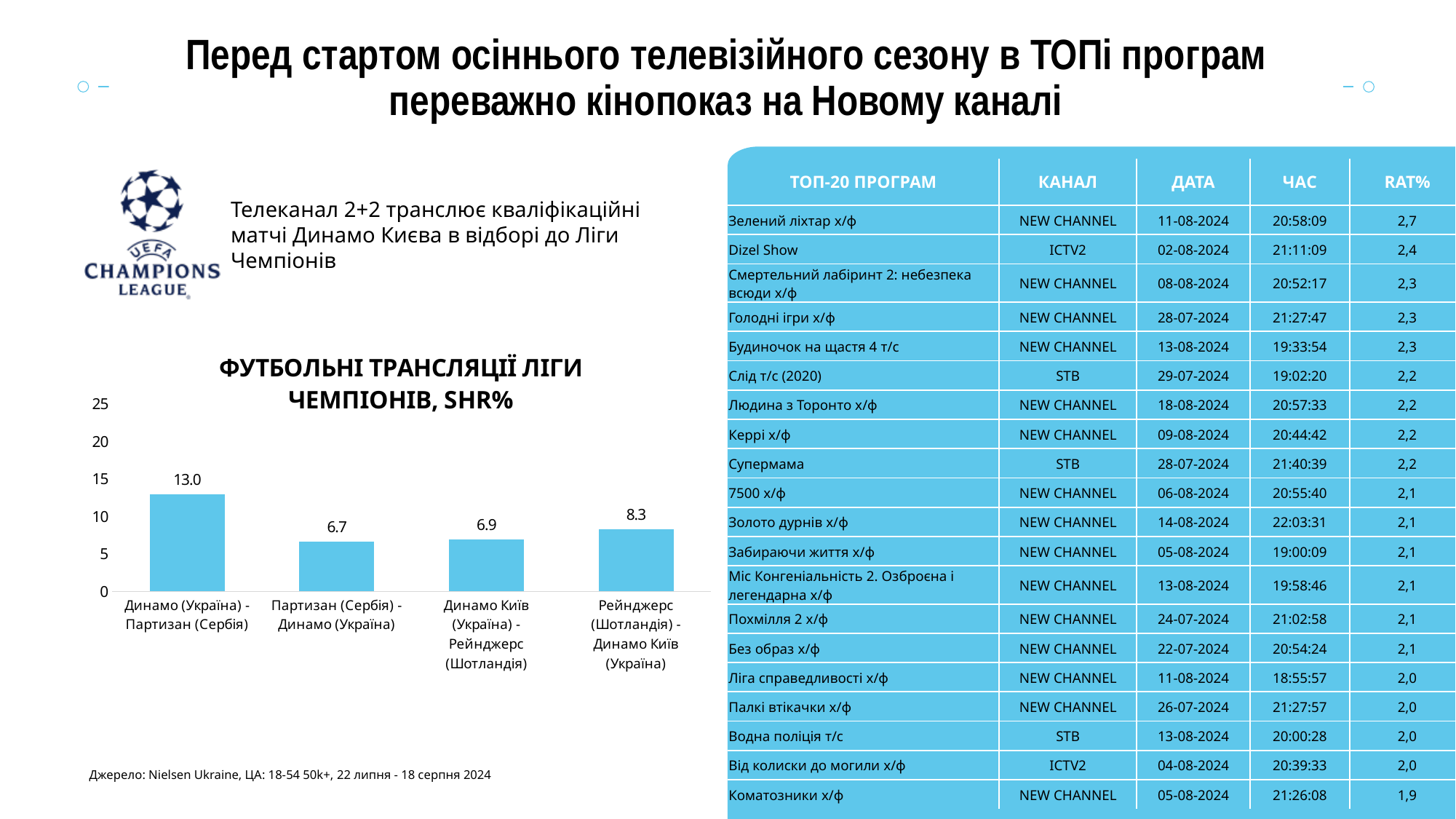
How many matches are shown in the chart? 4 What is the SHR% value for the Динамо (Україна) - Партизан (Сербія) match in the chart? 13.0 What is the SHR% value for the Рейнджерс (Шотландія) - Динамо Київ (Україна) match? 8.3 What is the SHR% value for the Партизан (Сербія) - Динамо (Україна) match? 6.7 What type of chart is used to show the Champions League broadcast SHR% values? bar chart What is the difference in SHR% between the Динамо (Україна) - Партизан (Сербія) match and the Партизан (Сербія) - Динамо (Україна) match? 6.3 What is the difference in SHR% between the Рейнджерс (Шотландія) - Динамо Київ (Україна) match and the Динамо Київ (Україна) - Рейнджерс (Шотландія) match? 1.4 Is the SHR% value for the Динамо (Україна) - Партизан (Сербія) match greater or less than 10? greater Which has a higher SHR%: the Рейнджерс (Шотландія) - Динамо Київ (Україна) match or the Партизан (Сербія) - Динамо (Україна) match? Рейнджерс (Шотландія) - Динамо Київ (Україна) Which match has the highest SHR% in the chart? Динамо (Україна) - Партизан (Сербія) What is the SHR% value for the Динамо Київ (Україна) - Рейнджерс (Шотландія) match? 6.9 Which match has the lowest SHR% in the chart? Партизан (Сербія) - Динамо (Україна)